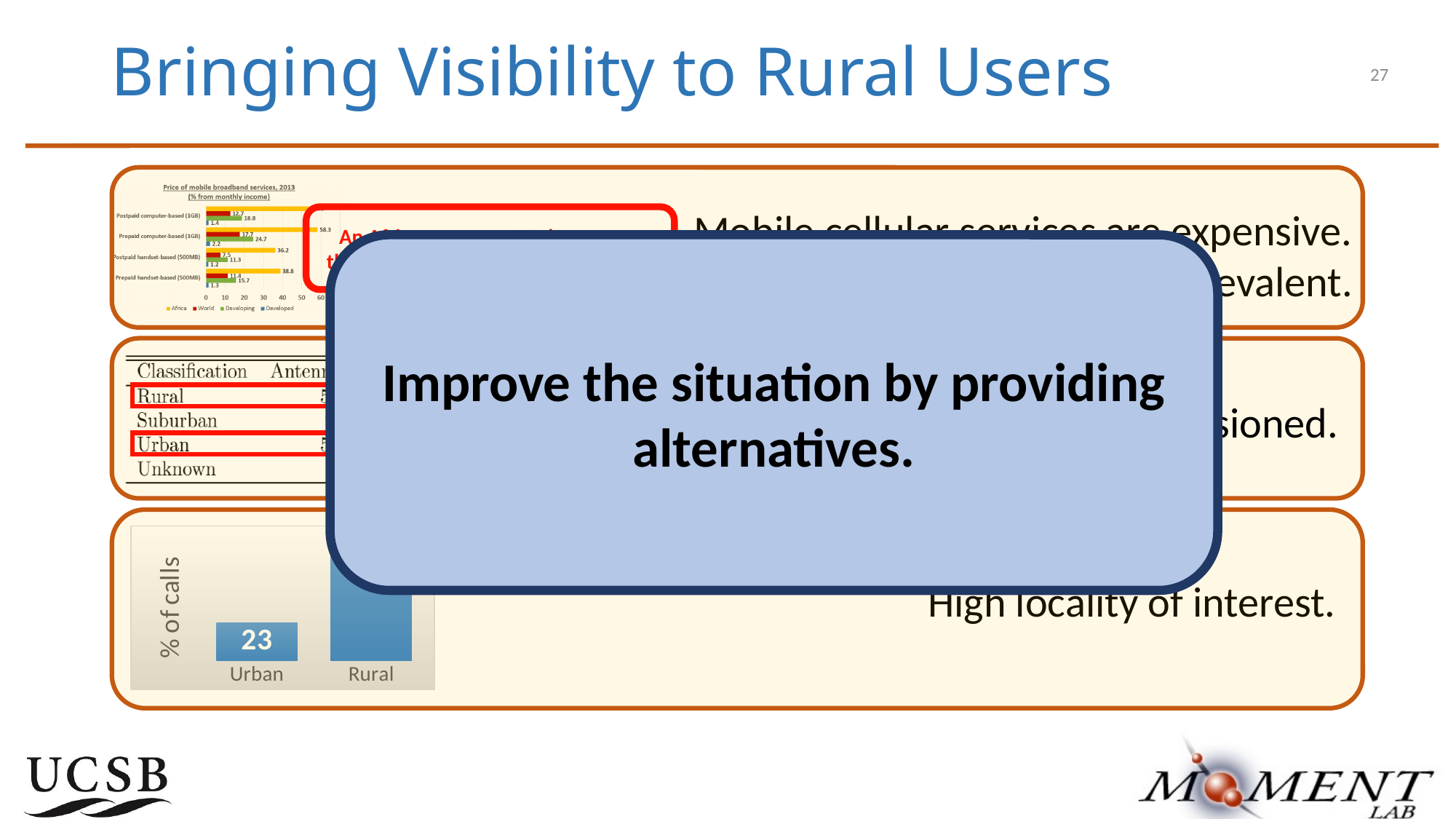
In the bottom-left '% of calls' chart, how many categories are shown on the x axis? 2 In the top-left 'Price of mobile broadband services, 2013' chart, which is larger for Prepaid handset-based (500MB): the Africa value or the Developed value? Africa In the bottom-left '% of calls' chart, what is the value for Urban? 23 What are the legend entries of the top-left 'Price of mobile broadband services, 2013' chart? Africa, World, Developing, Developed What kind of chart is the bottom-left '% of calls' chart? bar chart What kind of chart is the top-left 'Price of mobile broadband services, 2013' chart? bar chart In the bottom-left '% of calls' chart, which category has the taller bar, Urban or Rural? Rural How many series does the legend of the top-left 'Price of mobile broadband services, 2013' chart list? 4 In the top-left 'Price of mobile broadband services, 2013' chart, what is the difference between the Africa values for Prepaid handset-based (500MB) and Postpaid handset-based (500MB)? 2.6 In the top-left 'Price of mobile broadband services, 2013' chart, what is the Africa value for Prepaid handset-based (500MB)? 38.8 How many categories are shown on the y axis of the top-left 'Price of mobile broadband services, 2013' chart? 4 In the top-left 'Price of mobile broadband services, 2013' chart, what is the Africa value for Postpaid handset-based (500MB)? 36.2